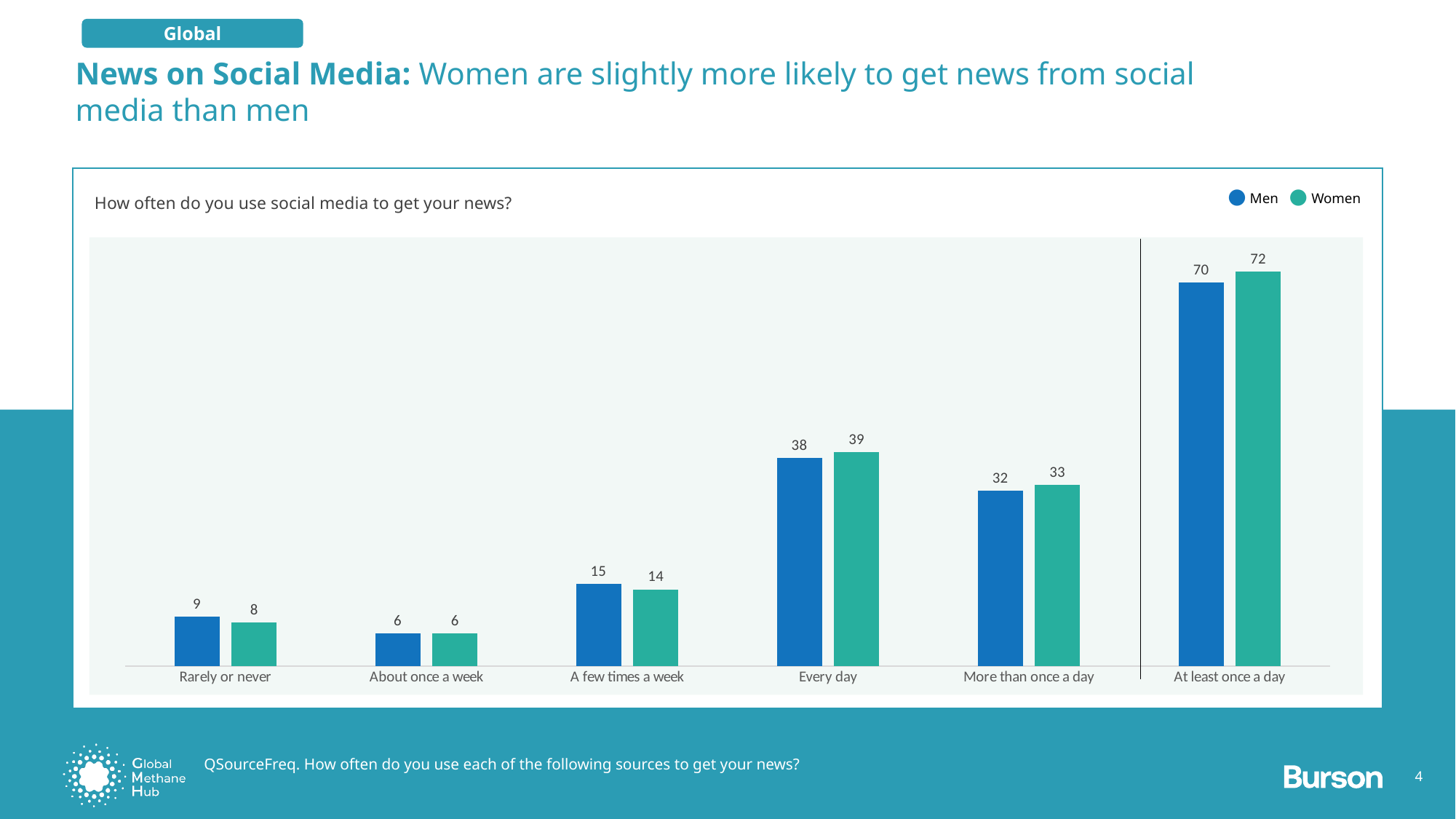
What is the value for Men in the 'At least once a day' category? 70 How many series does the legend list? 2 What question is shown as the chart's title? How often do you use social media to get your news? What is the difference between the Men values for 'Every day' and 'More than once a day'? 6 What is the value for Women in the 'Every day' category? 39 Which category has the lowest value for Men? About once a week In the 'Rarely or never' category, which is larger: the value for Men or for Women? Men Which category has the highest value for Women? At least once a day How many categories are shown on the x axis? 6 What kind of chart is shown on the slide? Bar chart What is the difference between the Women and Men values in the 'At least once a day' category? 2 What is the value for Men in the 'A few times a week' category? 15